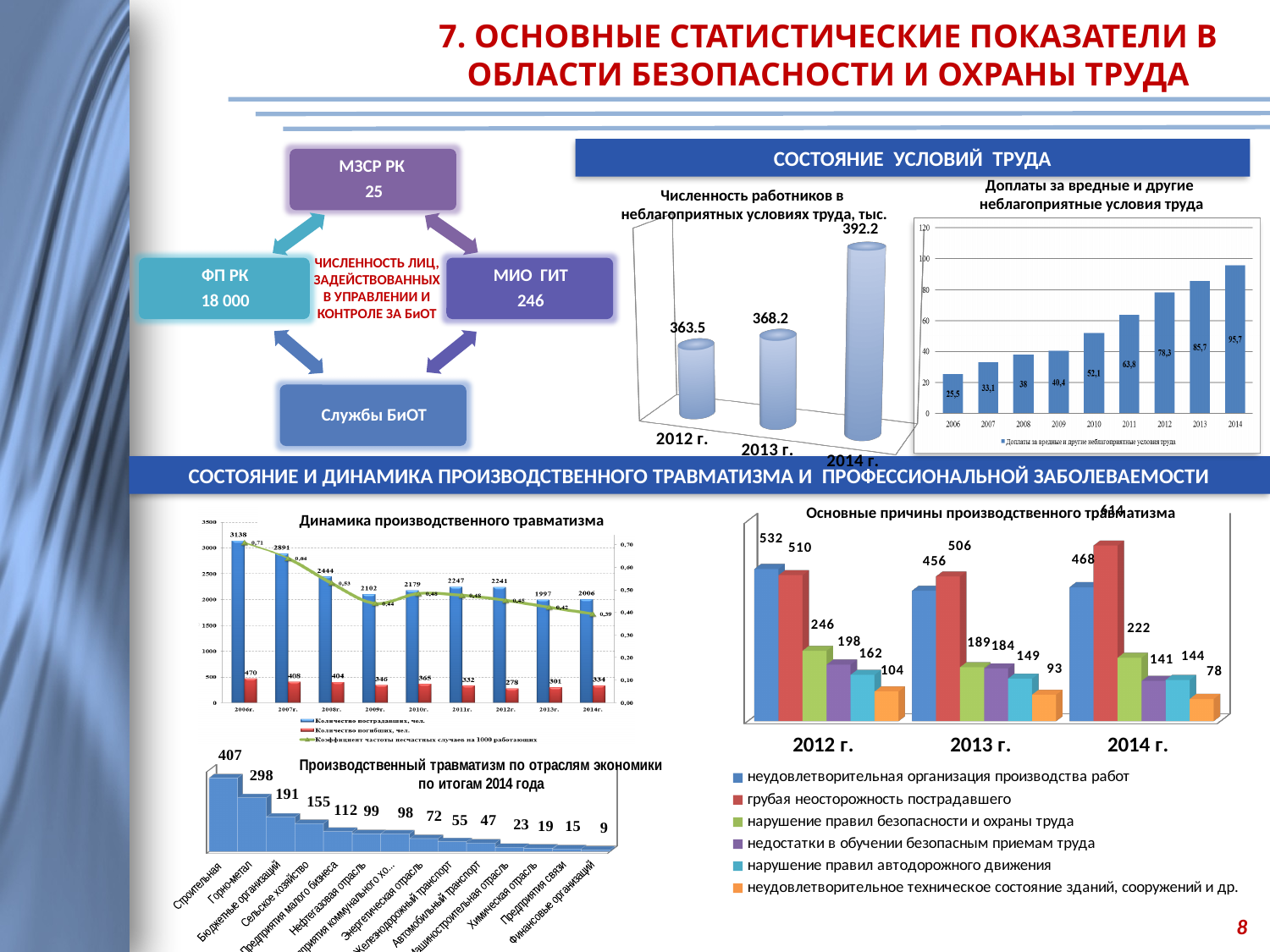
In the chart 'Основные причины производственного травматизма', what is the difference between 'неудовлетворительная организация производства работ' and 'грубая неосторожность пострадавшего' in 2012 г.? 22 In the chart 'Доплаты за вредные и другие неблагоприятные условия труда', how many years are shown on the x axis? 9 In the chart 'Динамика производственного травматизма', what is the number of injured (Количество пострадавших) in 2006? 3138 In the chart 'Численность работников в неблагоприятных условиях труда, тыс.', what is the value for 2014 г.? 392.2 In the chart 'Производственный травматизм по отраслям экономики по итогам 2014 года', which sector has the highest value? Строительная In the chart 'Динамика производственного травматизма', what is the coefficient value for 2014? 0,39 In the chart 'Динамика производственного травматизма', how many series does the legend list? 3 In the chart 'Доплаты за вредные и другие неблагоприятные условия труда', what is the value for 2010? 52,1 In the chart 'Численность работников в неблагоприятных условиях труда, тыс.', which year has the lowest value? 2012 г. In the chart 'Основные причины производственного травматизма', what is the value for 'грубая неосторожность пострадавшего' in 2014 г.? 614 In the chart 'Основные причины производственного травматизма', how many series does the legend list? 6 In the chart 'Доплаты за вредные и другие неблагоприятные условия труда', do the values rise or fall from 2006 to 2014? rise